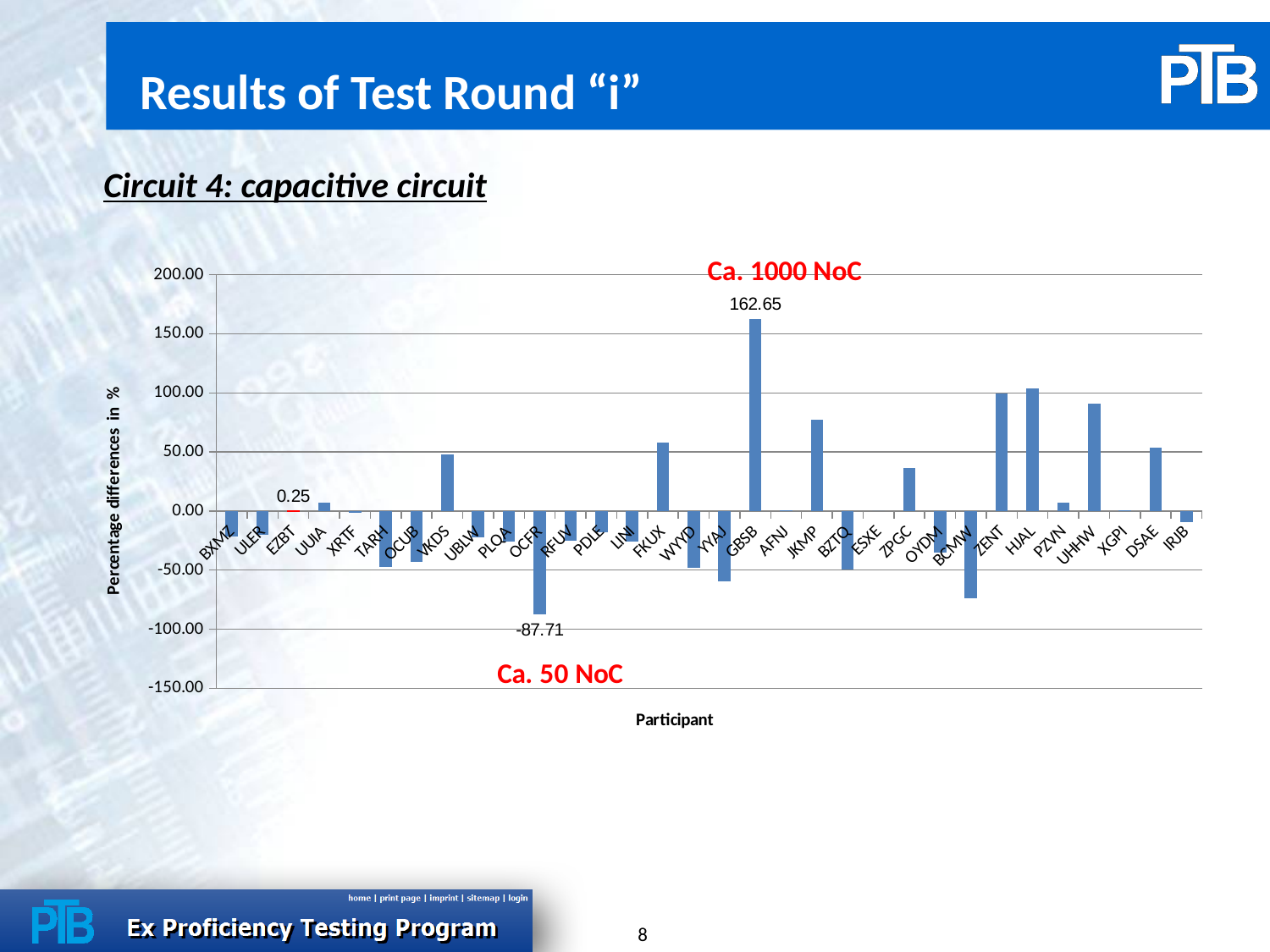
Is the value for JKMP greater or less than 50.00? greater Is the value for BCMW greater or less than -50.00? less Which participant has the highest percentage difference? GBSB Which participant has the lowest percentage difference? OCFR How many participants are shown on the x axis? 32 What kind of chart is shown on the slide? Bar chart Which is larger, the value for GBSB or the value for JKMP? GBSB What is the value for GBSB? 162.65 What is the value for OCFR? -87.71 What is the value for EZBT? 0.25 What is the difference between the values for GBSB and OCFR? 250.36